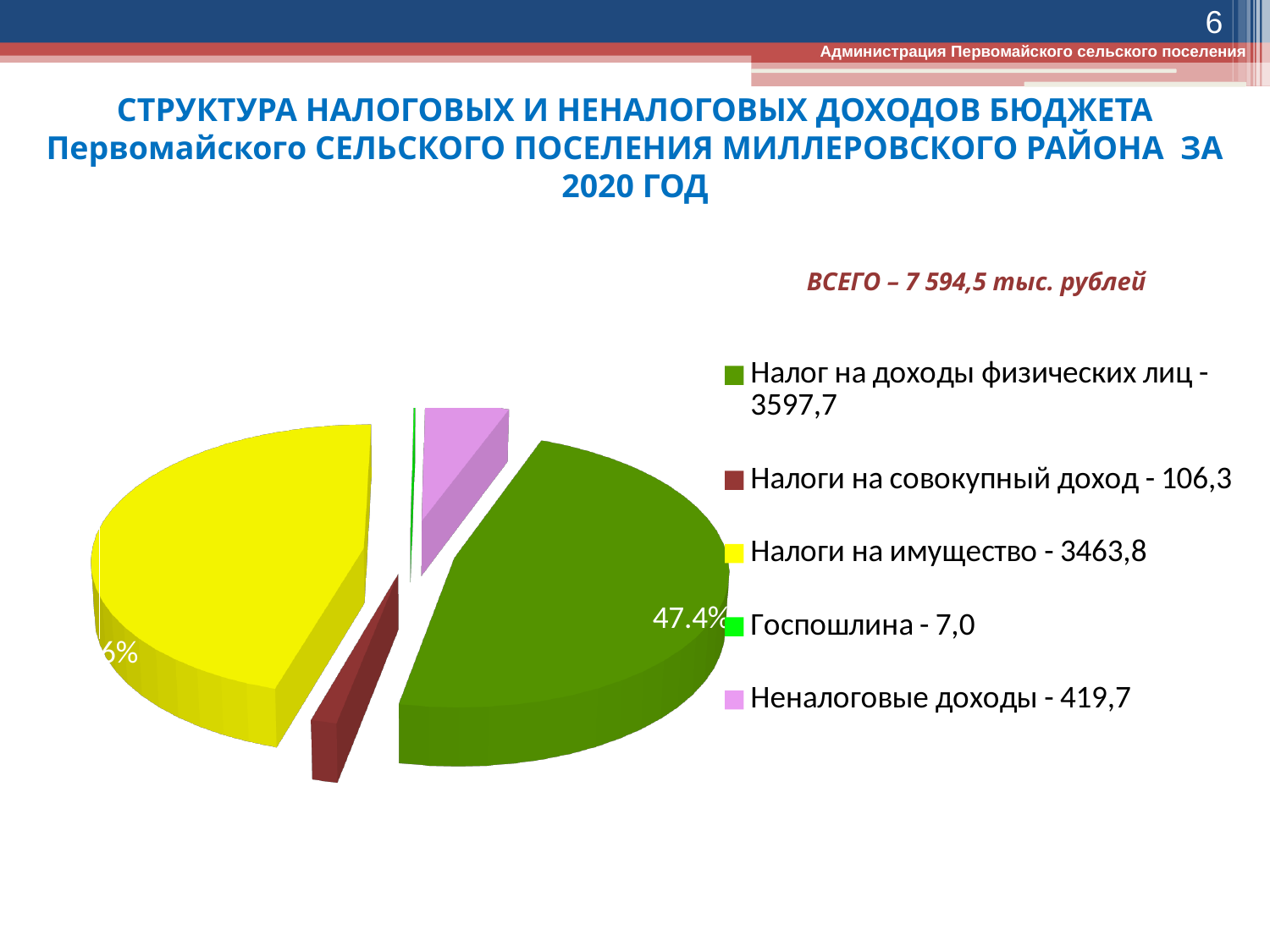
What value is given for Налоги на совокупный доход? 106,3 What value is given for Неналоговые доходы? 419,7 What share of the pie does the Налог на доходы физических лиц slice represent, according to its data label? 47.4% What is the difference between Налог на доходы физических лиц and Налоги на имущество? 133,9 Which category has the smallest value? Госпошлина How many categories does the pie chart show? 5 Which is larger: Неналоговые доходы or Налоги на совокупный доход? Неналоговые доходы What value is given for Налоги на имущество? 3463,8 What total amount (ВСЕГО) is stated on the slide? 7 594,5 тыс. рублей What kind of chart is shown on the slide? pie chart Which category has the largest value? Налог на доходы физических лиц What value is given for Налог на доходы физических лиц? 3597,7